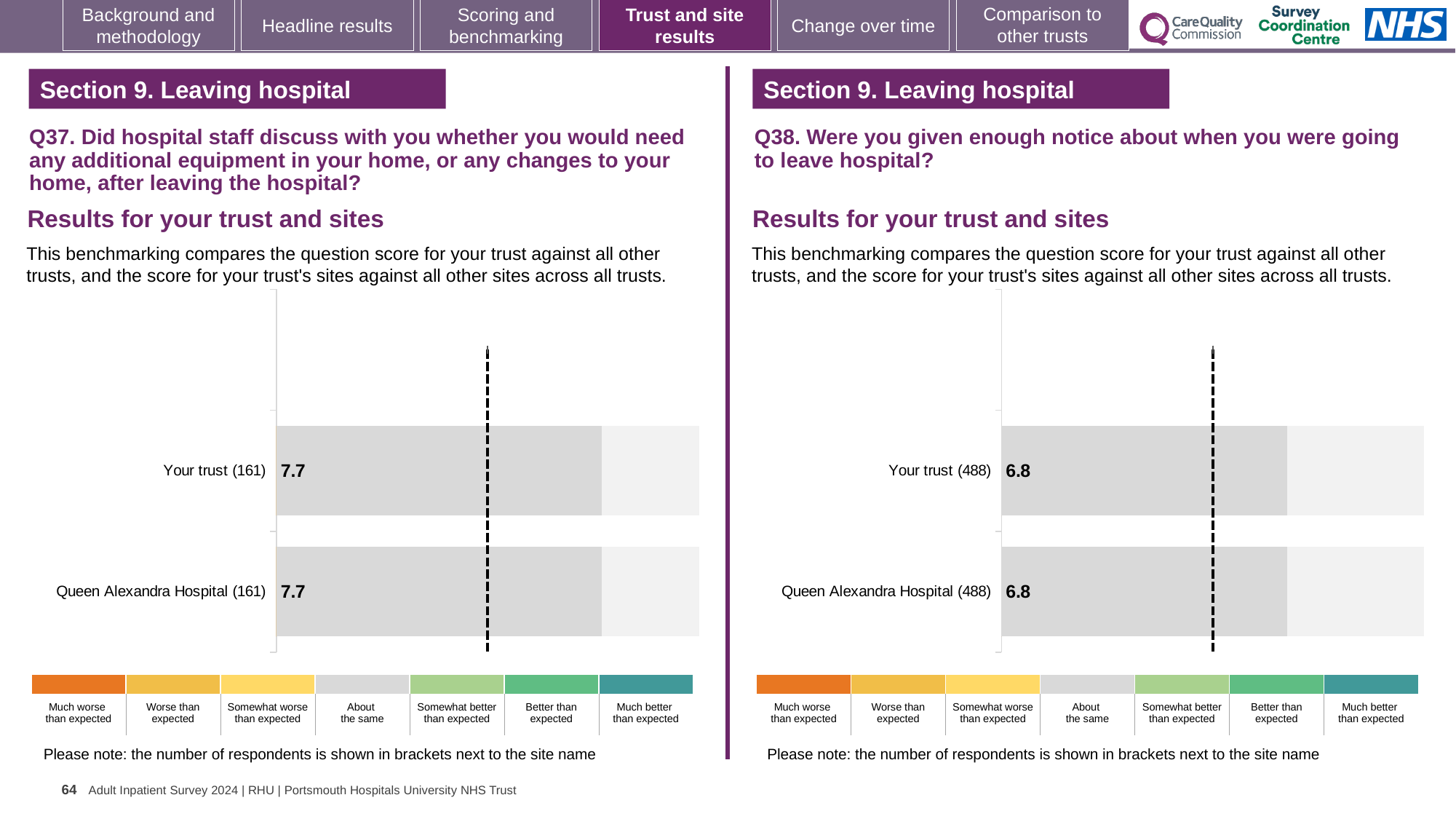
On the Q38 chart on the right, how many bars are plotted? 2 On the Q38 chart on the right, what is the score for Queen Alexandra Hospital? 6.8 On the Q37 chart on the left, what is the difference between the score for Your trust and the score for Queen Alexandra Hospital? 0 On the Q37 chart on the left, what is the score for Your trust? 7.7 On the Q37 chart on the left, what is the score for Queen Alexandra Hospital? 7.7 On the Q37 chart on the left, how many respondents are shown in brackets next to Your trust? 161 On the Q38 chart on the right, how many respondents are shown in brackets next to Queen Alexandra Hospital? 488 On the Q38 chart on the right, what is the score for Your trust? 6.8 Is the score for Your trust on the Q37 chart on the left larger than the score for Your trust on the Q38 chart on the right? Yes How many categories does the colour key below the Q37 chart on the left list? 7 On the Q38 chart on the right, which category in the colour key below the chart is shown in dark orange? Much worse than expected What kind of chart is the Q37 chart on the left? Bar chart